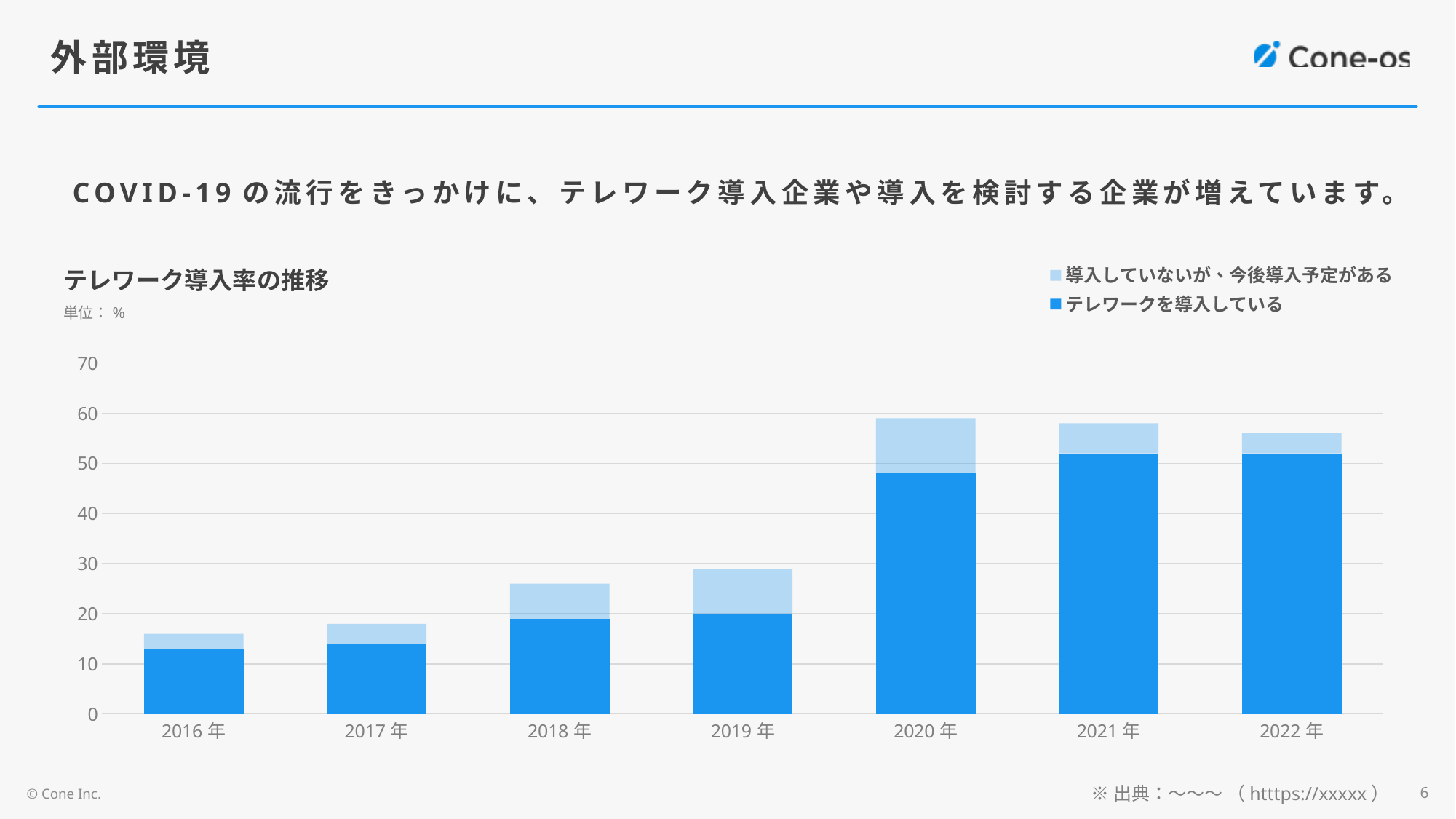
Is the value of テレワークを導入している for 2021年 greater or less than 40? greater Which year has the larger value for テレワークを導入している, 2016年 or 2022年? 2022年 Do the total stacked bar values rise or fall from 2016年 to 2020年? rise Is the total height of the stacked bar for 2016年 greater or less than 20? less Is the total height of the stacked bar for 2020年 greater or less than 50? greater Which year has the larger total stacked bar, 2019年 or 2020年? 2020年 What is the title of the chart? テレワーク導入率の推移 What kind of chart is shown on the slide? Stacked bar chart How many years (categories) are shown on the x axis of the chart? 7 What unit is stated for the chart's values? % How many series does the chart's legend list? 2